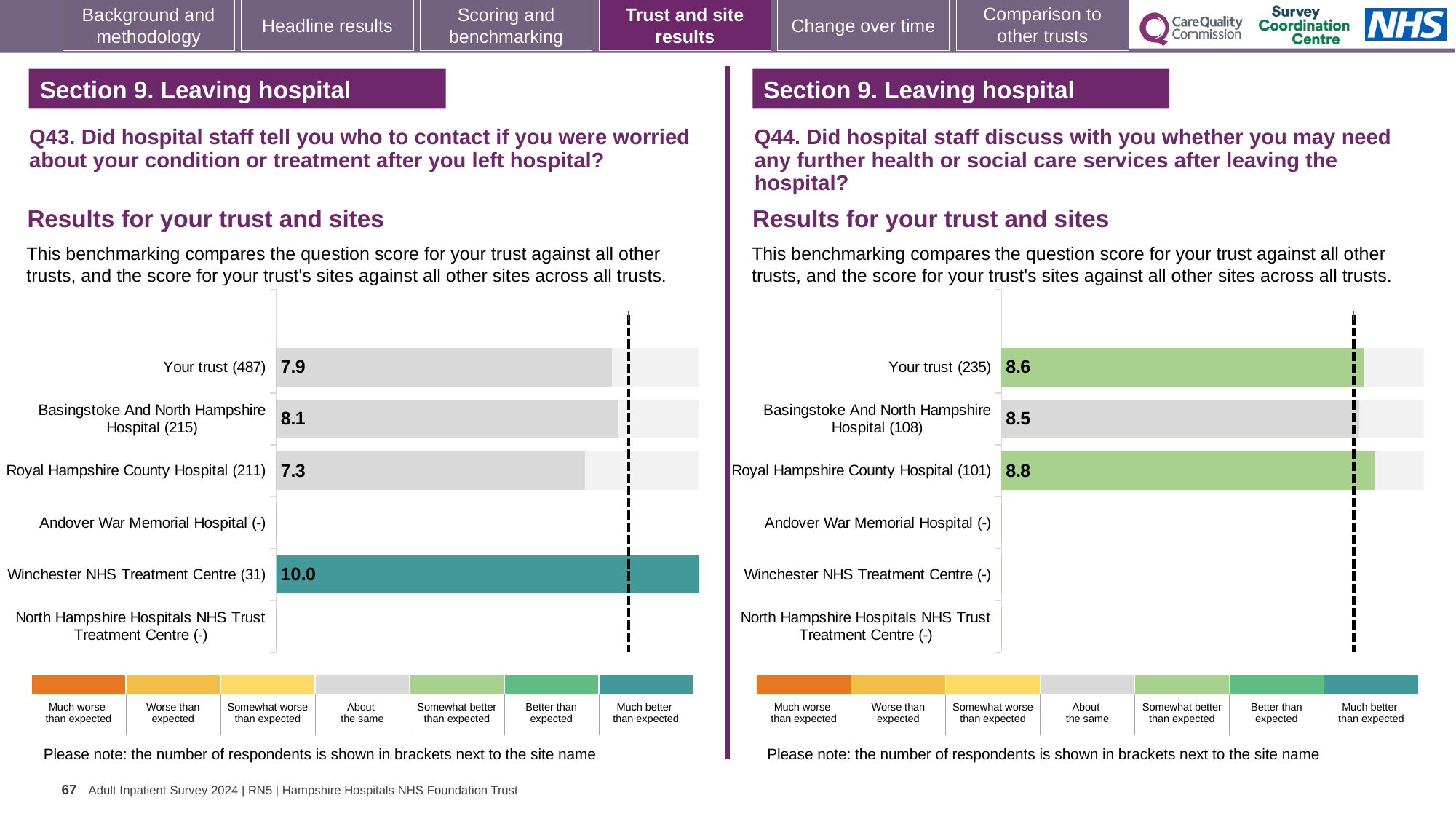
In the Q43 chart on the left, how many bars have a score shown? 4 In the Q43 chart on the left, which site has the highest score? Winchester NHS Treatment Centre (31) In the Q43 chart on the left, what is the score for Royal Hampshire County Hospital (211)? 7.3 In the Q43 chart on the left, what is the score for Your trust (487)? 7.9 In the Q43 chart on the left, what benchmark category does the colour of the Winchester NHS Treatment Centre (31) bar indicate? Much better than expected What kind of chart is used on the left for Q43? Bar chart In the Q44 chart on the right, which is larger: the score for Your trust (235) or Basingstoke And North Hampshire Hospital (108)? Your trust (235) In the Q44 chart on the right, what is the difference between the scores for Royal Hampshire County Hospital (101) and Basingstoke And North Hampshire Hospital (108)? 0.3 In the Q44 chart on the right, what is the score for Basingstoke And North Hampshire Hospital (108)? 8.5 In the Q44 chart on the right, which site has the highest score? Royal Hampshire County Hospital (101) In the Q43 chart on the left, what is the difference between the scores for Basingstoke And North Hampshire Hospital (215) and Royal Hampshire County Hospital (211)? 0.8 In the Q44 chart on the right, what is the score for Your trust (235)? 8.6